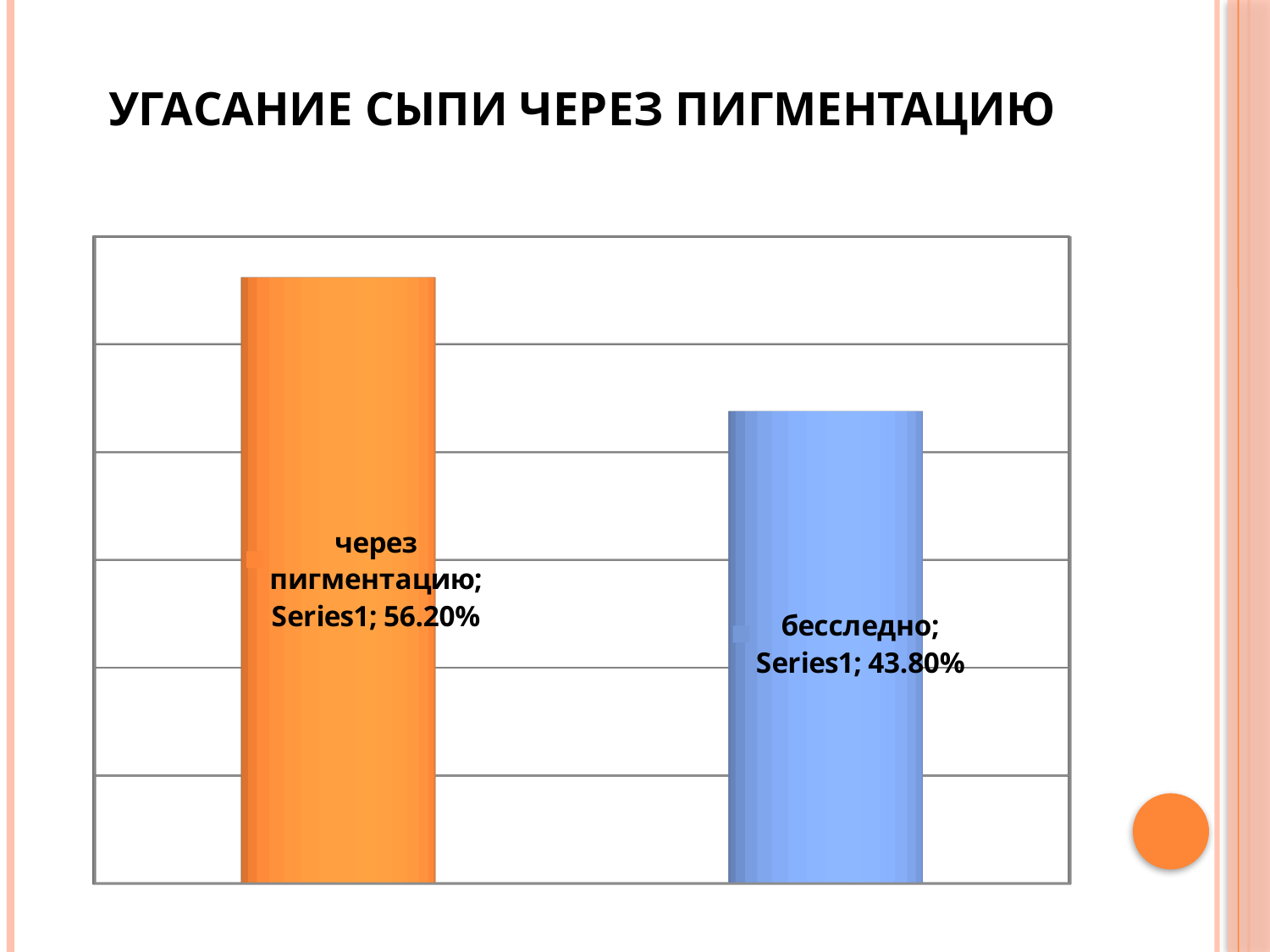
What is the difference between the values for "через пигментацию" and "бесследно"? 12.40% What is the title of the slide? УГАСАНИЕ СЫПИ ЧЕРЕЗ ПИГМЕНТАЦИЮ What is the total of the two values shown in the chart? 100.00% What colour is the bar for "бесследно"? blue What is the value for "через пигментацию"? 56.20% What is the value for "бесследно"? 43.80% What kind of chart is shown on the slide? bar chart Which category has the lowest value? бесследно How many categories are shown in the chart? 2 Which category has the highest value? через пигментацию Which is larger, the value for "через пигментацию" or the value for "бесследно"? через пигментацию